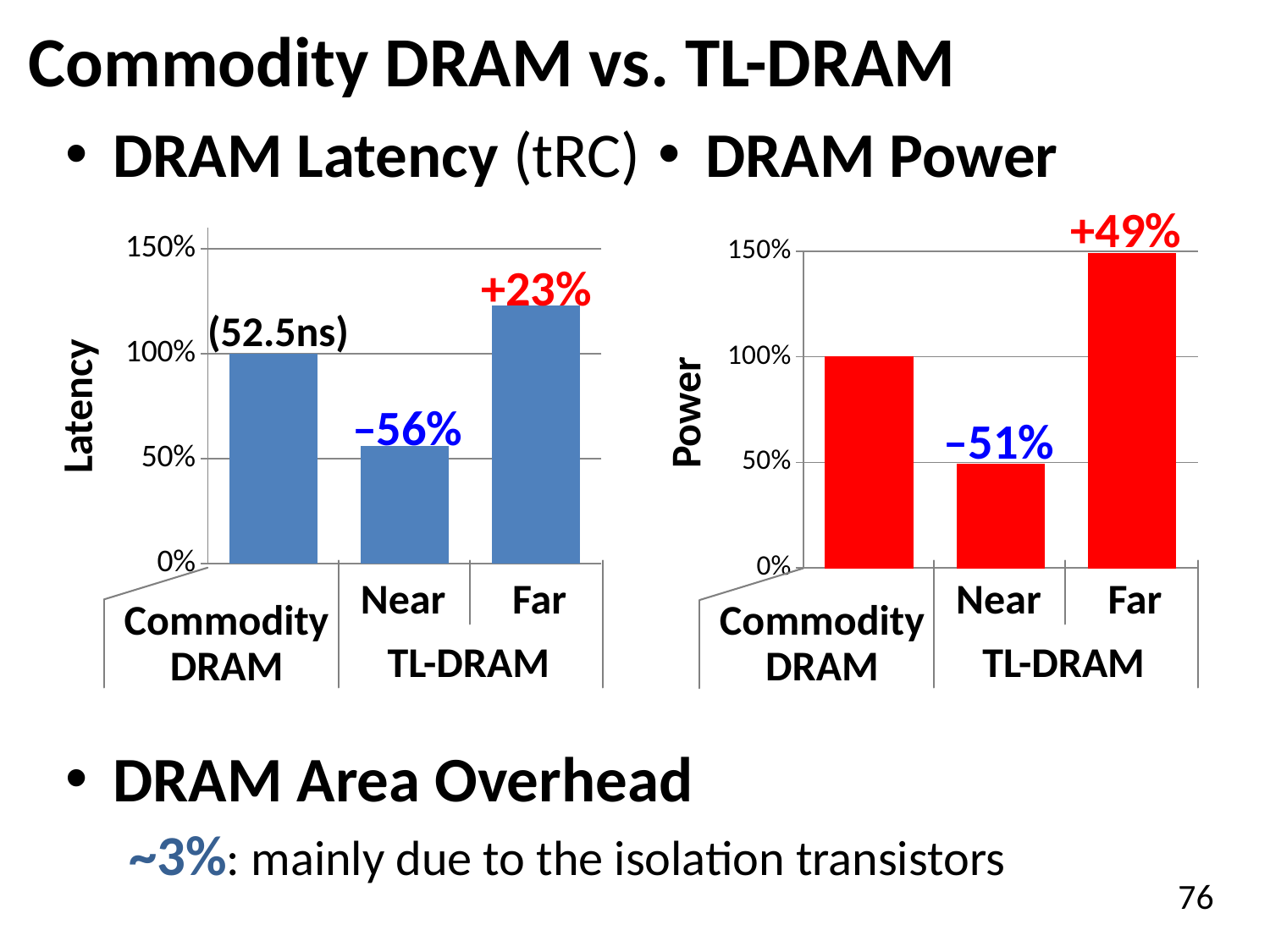
In the DRAM Power chart, which bar is the highest? Far In the DRAM Power chart, which is larger, the Commodity DRAM bar or the Near bar? Commodity DRAM In the DRAM Latency chart, is the value for Near greater or less than 50%? greater In the DRAM Latency chart, what absolute latency is printed next to the Commodity DRAM bar? (52.5ns) What colour are the bars in the DRAM Power chart? Red In the DRAM Power chart, what percentage change is printed above the Far bar? +49% How many bars are plotted in the DRAM Latency chart? 3 In the DRAM Latency chart, what percentage change is printed above the Far bar? +23% In the DRAM Latency chart, which bar is the lowest? Near In the DRAM Power chart, is the value for Far greater or less than 100%? greater In the DRAM Power chart, what percentage change is printed above the Near bar? –51% In the DRAM Latency chart, what percentage change is printed above the Near bar? –56%